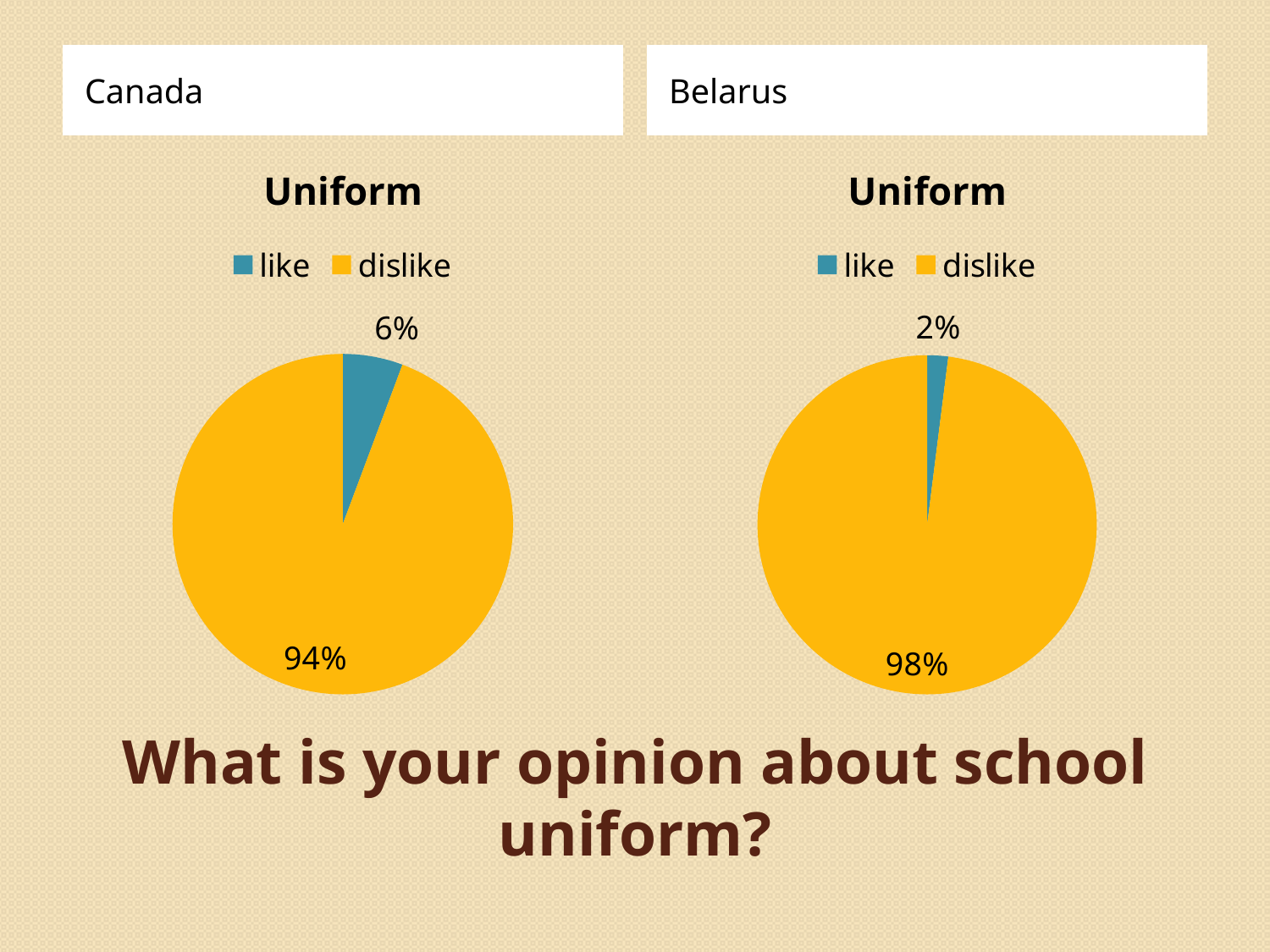
Which country's chart shows a larger 'like' share, Canada or Belarus? Canada In the Belarus chart, which category has the smallest share? like What is the title of the Belarus chart? Uniform How many categories does the Belarus chart show? 2 In the Canada chart, what percentage of respondents like school uniform? 6% In the Belarus chart, what percentage of respondents like school uniform? 2% In the Canada chart, which category has the largest share? dislike In the Canada chart, what percentage of respondents dislike school uniform? 94% In the Belarus chart, what percentage of respondents dislike school uniform? 98% What is the difference between the 'dislike' and 'like' shares in the Canada chart? 88% What type of chart is used for the Canada data? Pie chart How many entries does the legend of the Canada chart list? 2